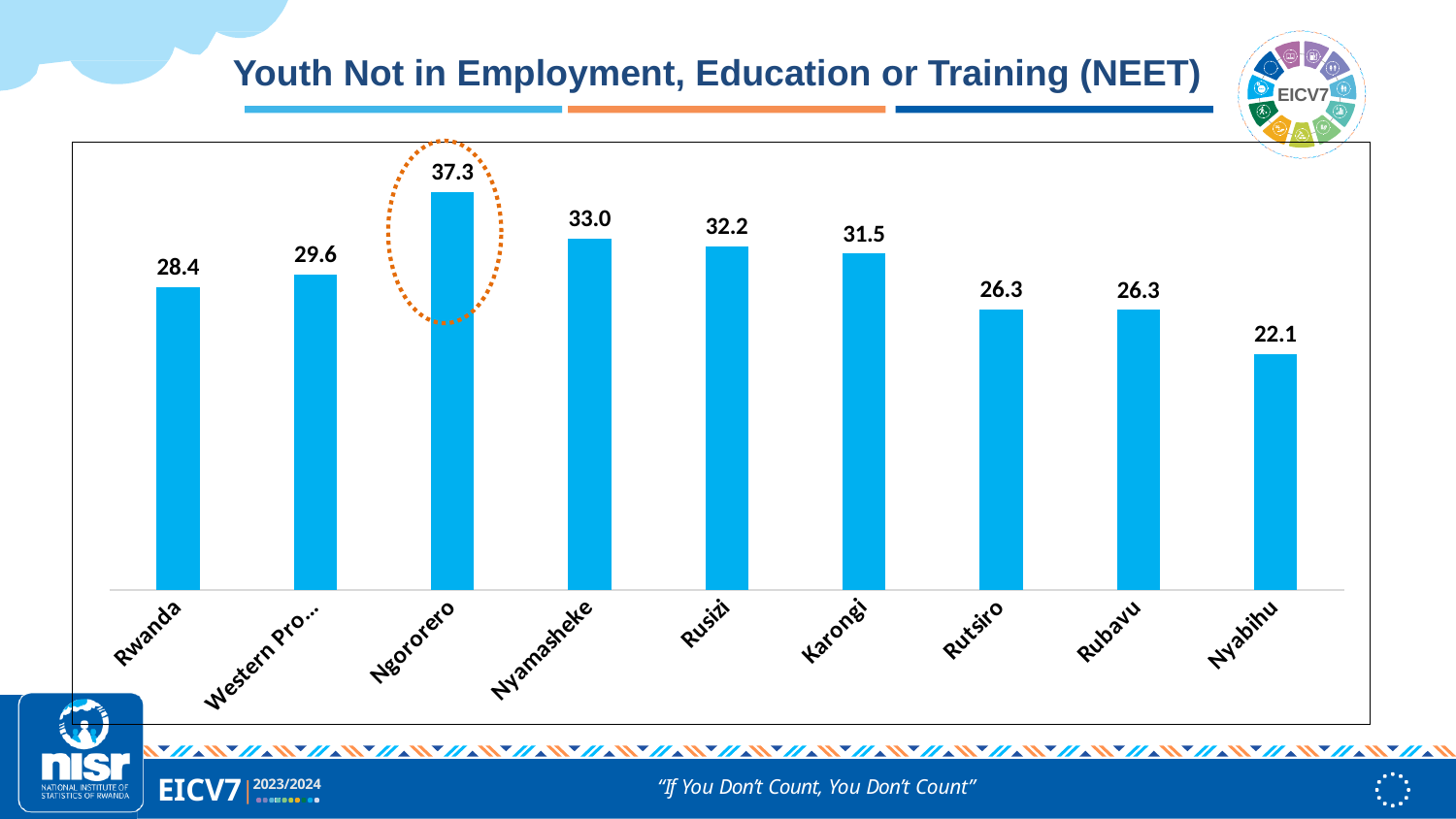
What is the value for Nyamasheke? 33.0 What is the title of the chart? Youth Not in Employment, Education or Training (NEET) What is the difference between the values for Nyamasheke and Rusizi? 0.8 Which category has the lowest value? Nyabihu What is the value for Nyabihu? 22.1 Which category has the highest value? Ngororero What kind of chart is shown on the slide? Bar chart Which is larger, the value for Karongi or the value for Rutsiro? Karongi How many categories are shown on the chart? 9 What is the value for Rwanda? 28.4 What is the difference between the values for Ngororero and Nyabihu? 15.2 What is the value for Ngororero? 37.3